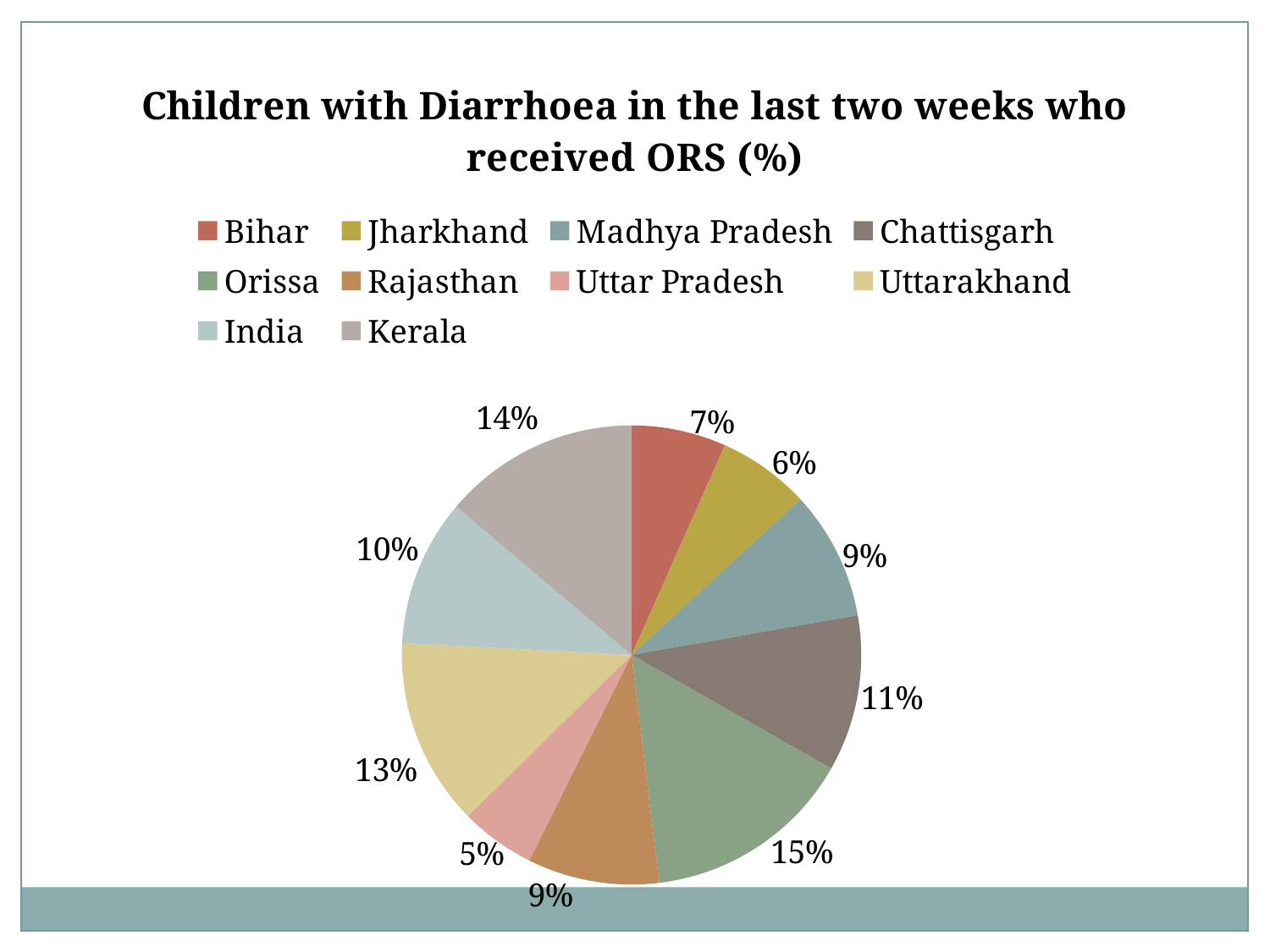
What kind of chart is shown on the slide? pie chart Which slice is larger, Uttarakhand or India? Uttarakhand What share of the pie does Uttar Pradesh have? 5% What is the difference in percentage points between the Orissa slice and the Jharkhand slice? 9 What share of the pie does Orissa have? 15% What share of the pie does Chattisgarh have? 11% What is the title of the chart? Children with Diarrhoea in the last two weeks who received ORS (%) How many entries does the legend list? 10 Which category has the smallest slice of the pie? Uttar Pradesh Which category has the largest slice of the pie? Orissa